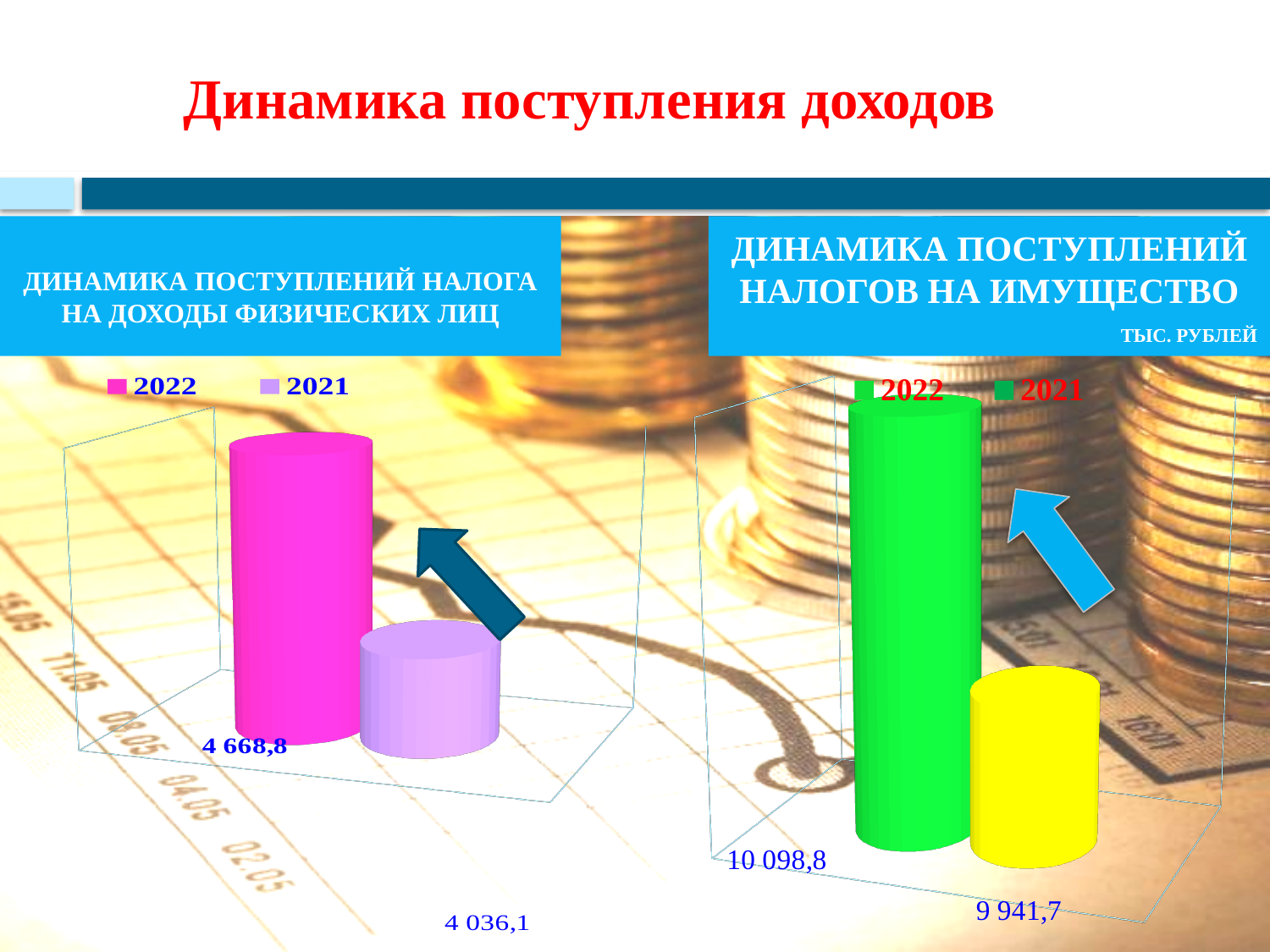
On the right chart (property taxes), what is the value for 2021? 9 941,7 On the right chart (property taxes), what is the difference between the 2022 and 2021 values? 157,1 On the right chart (property taxes), is the value for 2022 larger or smaller than the value for 2021? larger On the chart titled 'ДИНАМИКА ПОСТУПЛЕНИЙ НАЛОГА НА ДОХОДЫ ФИЗИЧЕСКИХ ЛИЦ' (left), what is the value for 2022? 4 668,8 On the right chart (property taxes), what colour is the bar for 2021? yellow On the left chart (personal income tax), which year has the higher value? 2022 On the left chart (personal income tax), what is the difference between the 2022 and 2021 values? 632,7 What kind of chart is the right chart (property taxes)? bar chart On the chart titled 'ДИНАМИКА ПОСТУПЛЕНИЙ НАЛОГОВ НА ИМУЩЕСТВО' (right), what is the value for 2022? 10 098,8 How many series does the legend of the left chart (personal income tax) list? 2 On the left chart (personal income tax), what is the value for 2021? 4 036,1 On the right chart (property taxes), which year has the lower value? 2021